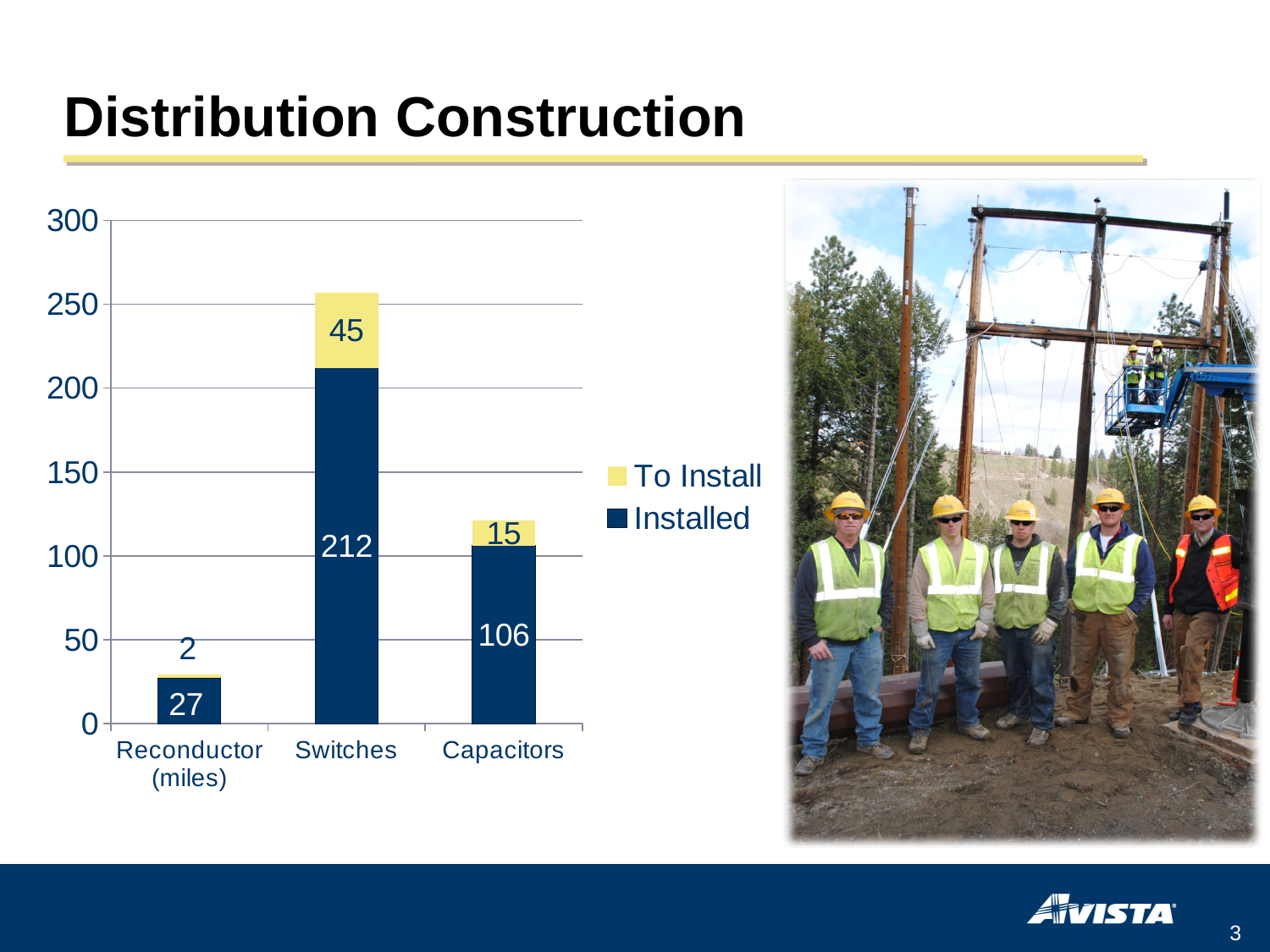
What is the To Install value for Switches? 45 What is the To Install value for Capacitors? 15 Which category has the highest Installed value? Switches What is the difference between the Installed values for Switches and Capacitors? 106 How many series does the legend list? 2 What is the Installed value for Reconductor (miles)? 27 What is the total of the stacked bar for Capacitors? 121 Is the Installed value for Capacitors larger than the Installed value for Reconductor (miles)? Yes How many categories are shown on the x axis? 3 Which category has the lowest To Install value? Reconductor (miles) What is the total of the stacked bar for Switches? 257 What is the Installed value for Switches? 212